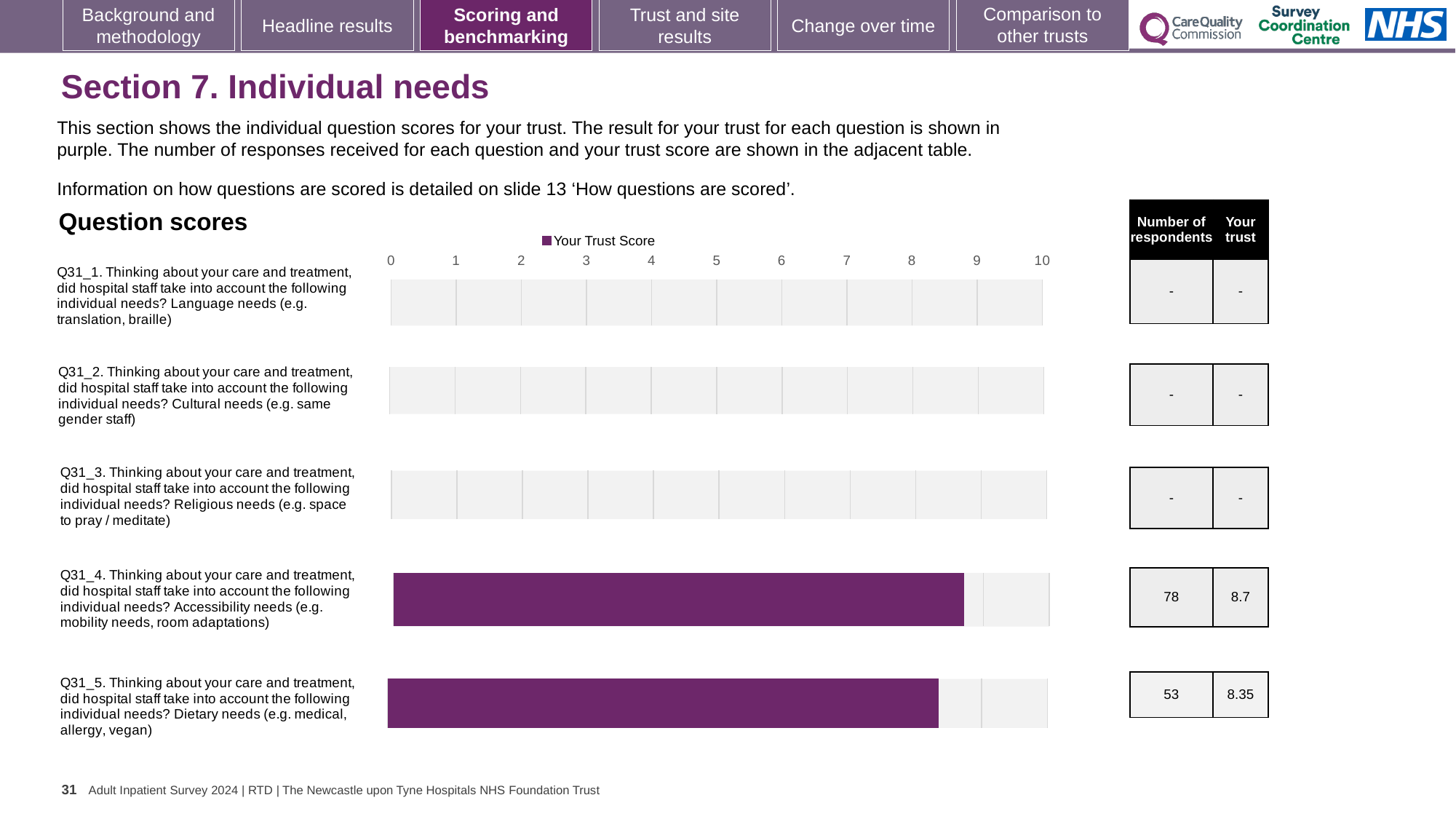
What is the difference between the trust scores for Q31_4 (Accessibility needs) and Q31_5 (Dietary needs)? 0.35 What is the trust score for Q31_4 (Accessibility needs)? 8.7 How many respondents answered Q31_4 (Accessibility needs)? 78 Is the trust score for Q31_5 (Dietary needs) greater or less than 8? greater How many respondents answered Q31_5 (Dietary needs)? 53 How many of the questions in the Question scores chart have a plotted trust score bar? 2 Which question has the higher trust score, Q31_4 (Accessibility needs) or Q31_5 (Dietary needs)? Q31_4 (Accessibility needs) Is the trust score for Q31_4 (Accessibility needs) greater or less than 9? less What kind of chart is used to show the question scores? Bar chart How many series does the legend of the Question scores chart list? 1 What is the trust score for Q31_5 (Dietary needs)? 8.35 How many questions are listed in the Question scores chart? 5